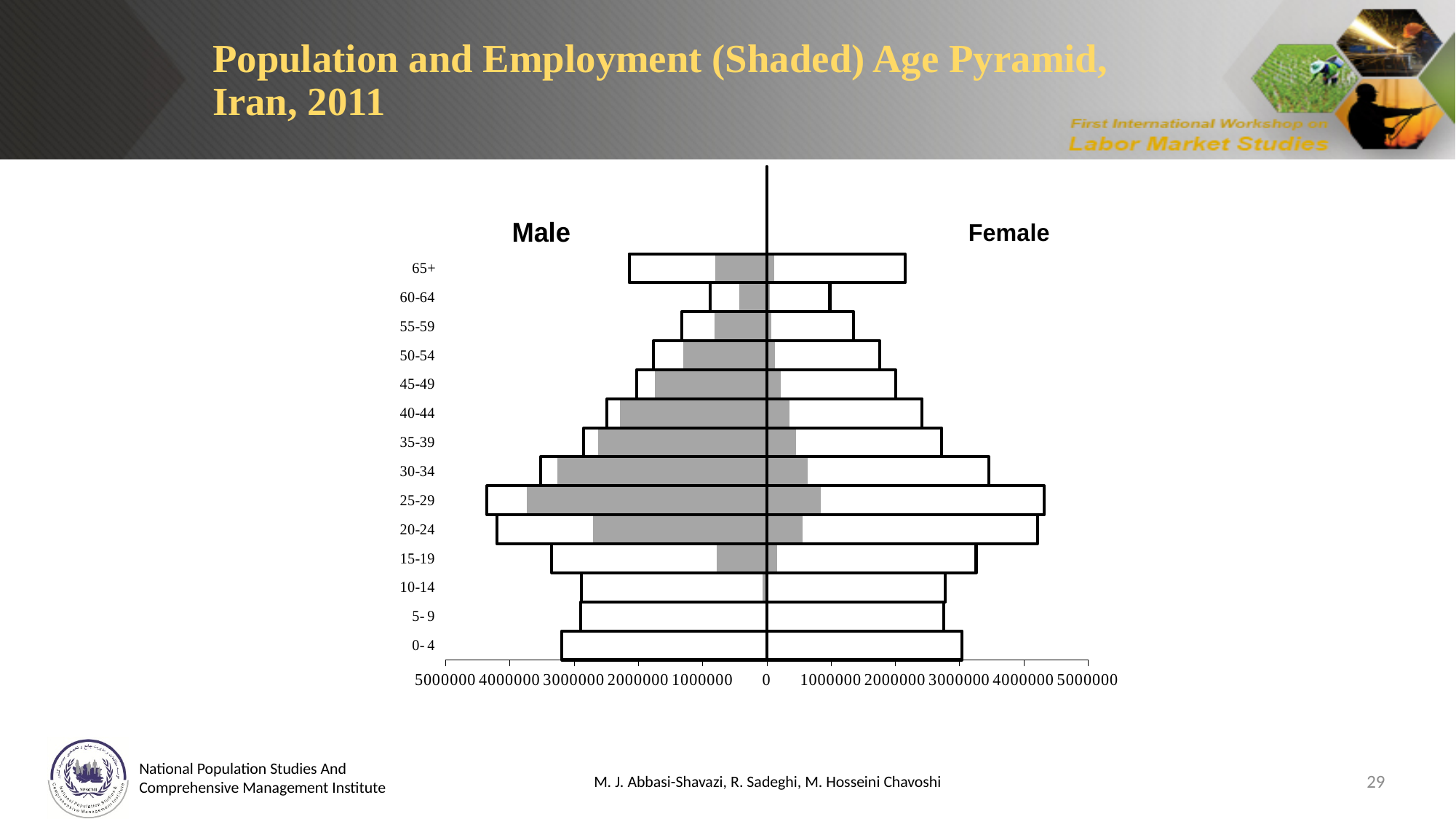
Is the female population for the 25-29 age group greater or less than 4000000? greater Is the male population for the 25-29 age group greater or less than 4000000? greater Which age group has the largest female population bar? 25-29 What does the shaded portion of each bar represent, according to the chart title? Employment Is the male population for the 25-29 age group larger or smaller than the male population for the 65+ age group? larger Is the male population for the 60-64 age group greater or less than 1000000? less Which age group has the largest male population bar? 25-29 How many age groups are shown on the vertical axis of the pyramid? 14 Which age group has the smallest male population bar? 60-64 What kind of chart is shown on the slide? bar chart (population pyramid) Which age group has the smallest female population bar? 60-64